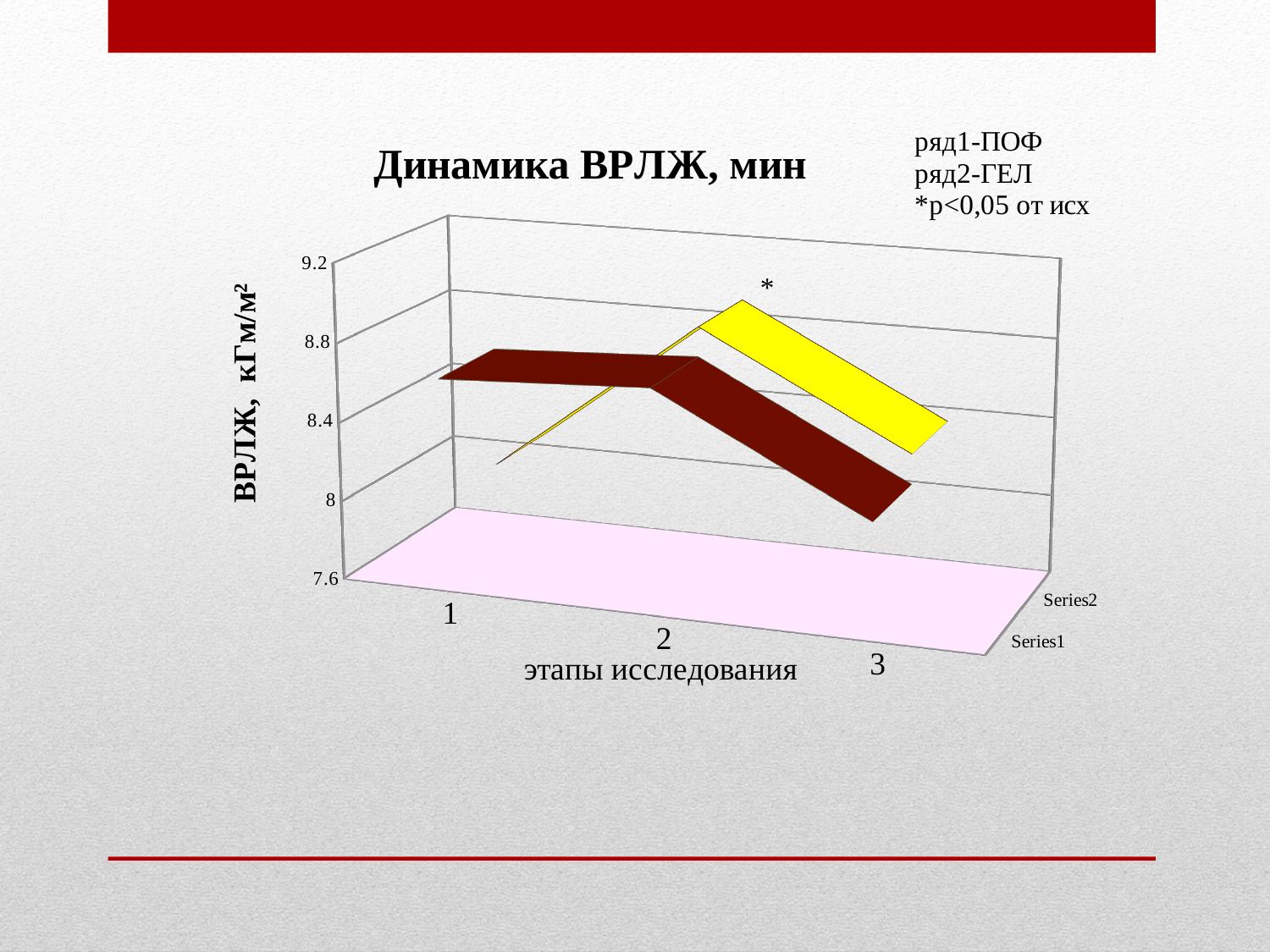
At which stage is Series2 marked with an asterisk (*)? 2 How many series does the chart plot? 2 Does the value for Series1 rise or fall from stage 2 to stage 3? fall What is the label of the vertical axis? ВРЛЖ, кГм/м² What kind of chart is shown on the slide? line chart Does the value for Series2 rise or fall from stage 2 to stage 3? fall Which series has the higher value at stage 2, Series1 or Series2? Series2 Does the value for Series2 rise or fall from stage 1 to stage 2? rise What is the title of the chart? Динамика ВРЛЖ, мин How many stages (этапы исследования) are shown on the x axis? 3